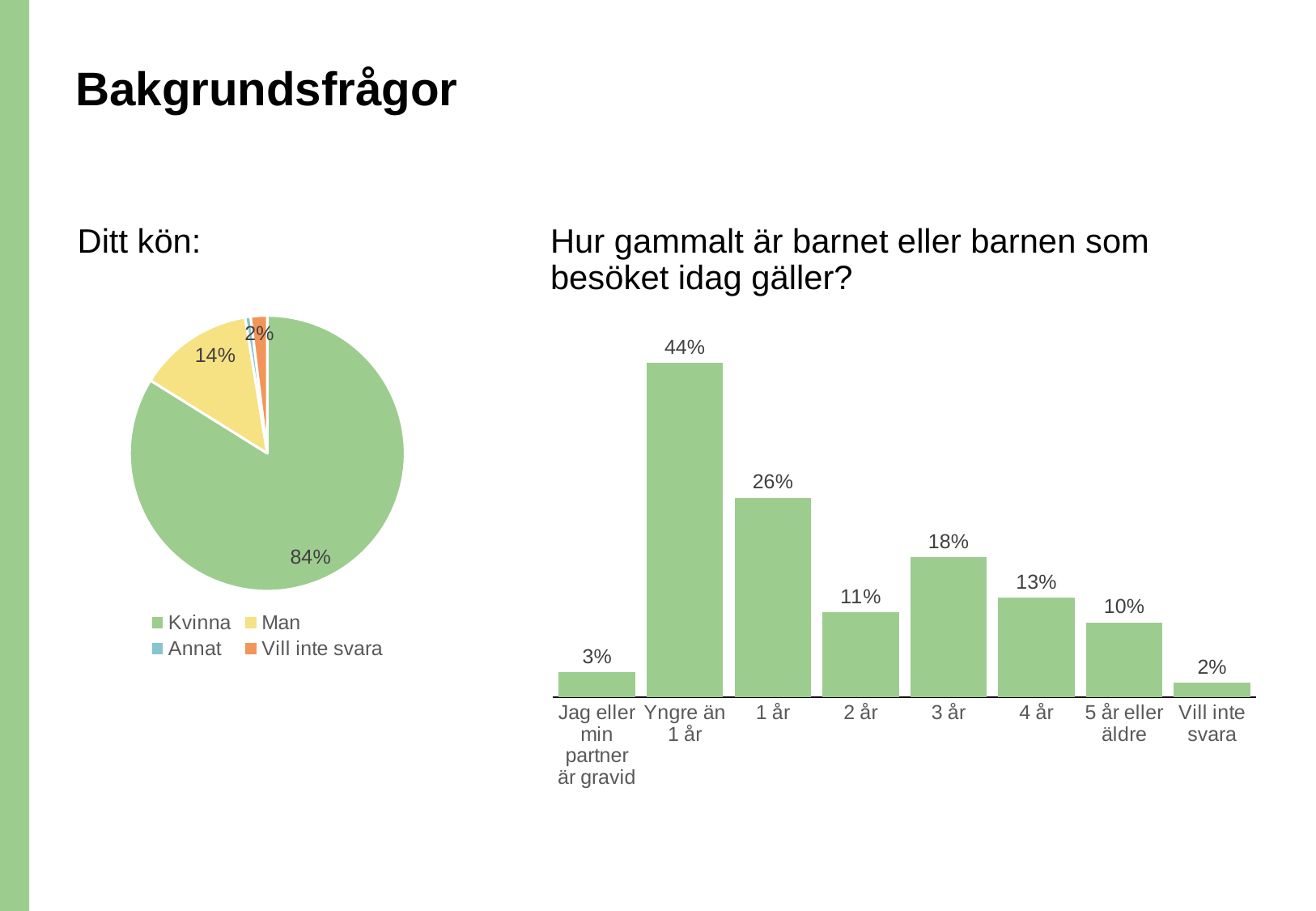
In the 'Hur gammalt är barnet eller barnen som besöket idag gäller?' chart, what is the value for 'Yngre än 1 år'? 44% In the 'Ditt kön:' chart, what share of respondents answered Kvinna? 84% How many entries does the legend of the 'Ditt kön:' chart list? 4 In the 'Hur gammalt är barnet eller barnen som besöket idag gäller?' chart, which category has the highest value? Yngre än 1 år In the 'Ditt kön:' chart, which category has the largest slice? Kvinna How many categories are shown in the 'Hur gammalt är barnet eller barnen som besöket idag gäller?' chart? 8 In the 'Ditt kön:' chart, what share of respondents answered Man? 14% What kind of chart is the 'Ditt kön:' chart? Pie chart In the 'Hur gammalt är barnet eller barnen som besöket idag gäller?' chart, which is larger, the value for '4 år' or '5 år eller äldre'? 4 år In the 'Hur gammalt är barnet eller barnen som besöket idag gäller?' chart, which category has the lowest value? Vill inte svara In the 'Hur gammalt är barnet eller barnen som besöket idag gäller?' chart, what is the difference between the values for '1 år' and '2 år'? 15% In the 'Hur gammalt är barnet eller barnen som besöket idag gäller?' chart, what is the value for '3 år'? 18%